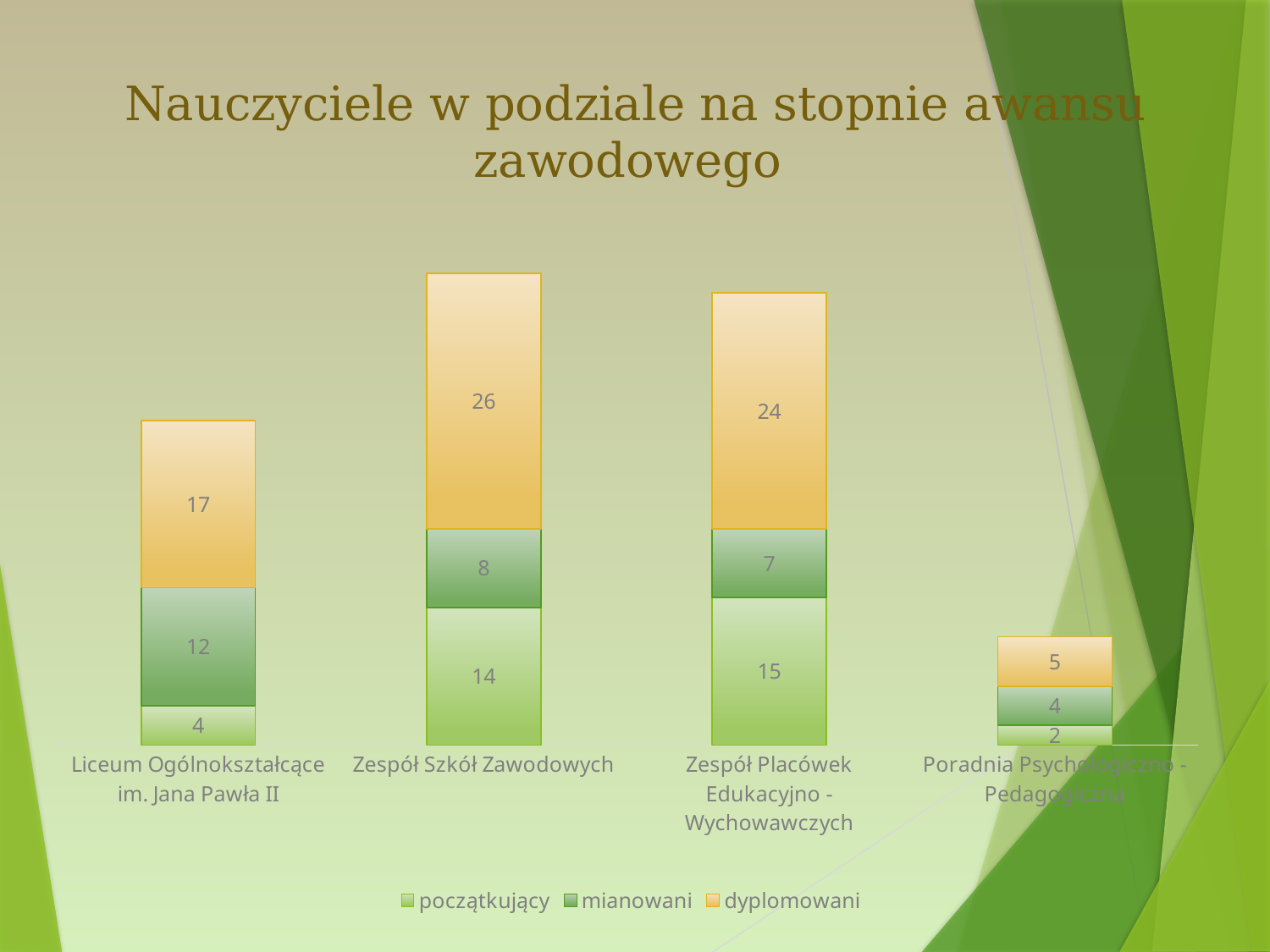
What is the value of początkujący for Liceum Ogólnokształcące im. Jana Pawła II? 4 How many series does the legend list? 3 Which category has the lowest value for początkujący? Poradnia Psychologiczno - Pedagogiczna What is the difference between the dyplomowani values for Zespół Szkół Zawodowych and Liceum Ogólnokształcące im. Jana Pawła II? 9 How many categories are shown on the x axis? 4 What is the value of mianowani for Zespół Placówek Edukacyjno - Wychowawczych? 7 What is the value of dyplomowani for Zespół Szkół Zawodowych? 26 What is the total of the stacked bar for Poradnia Psychologiczno - Pedagogiczna? 11 What type of chart is shown on the slide? stacked bar chart Which category has the highest value for dyplomowani? Zespół Szkół Zawodowych What is the total of the stacked bar for Zespół Szkół Zawodowych? 48 Which is larger: mianowani for Liceum Ogólnokształcące im. Jana Pawła II or mianowani for Zespół Szkół Zawodowych? Liceum Ogólnokształcące im. Jana Pawła II